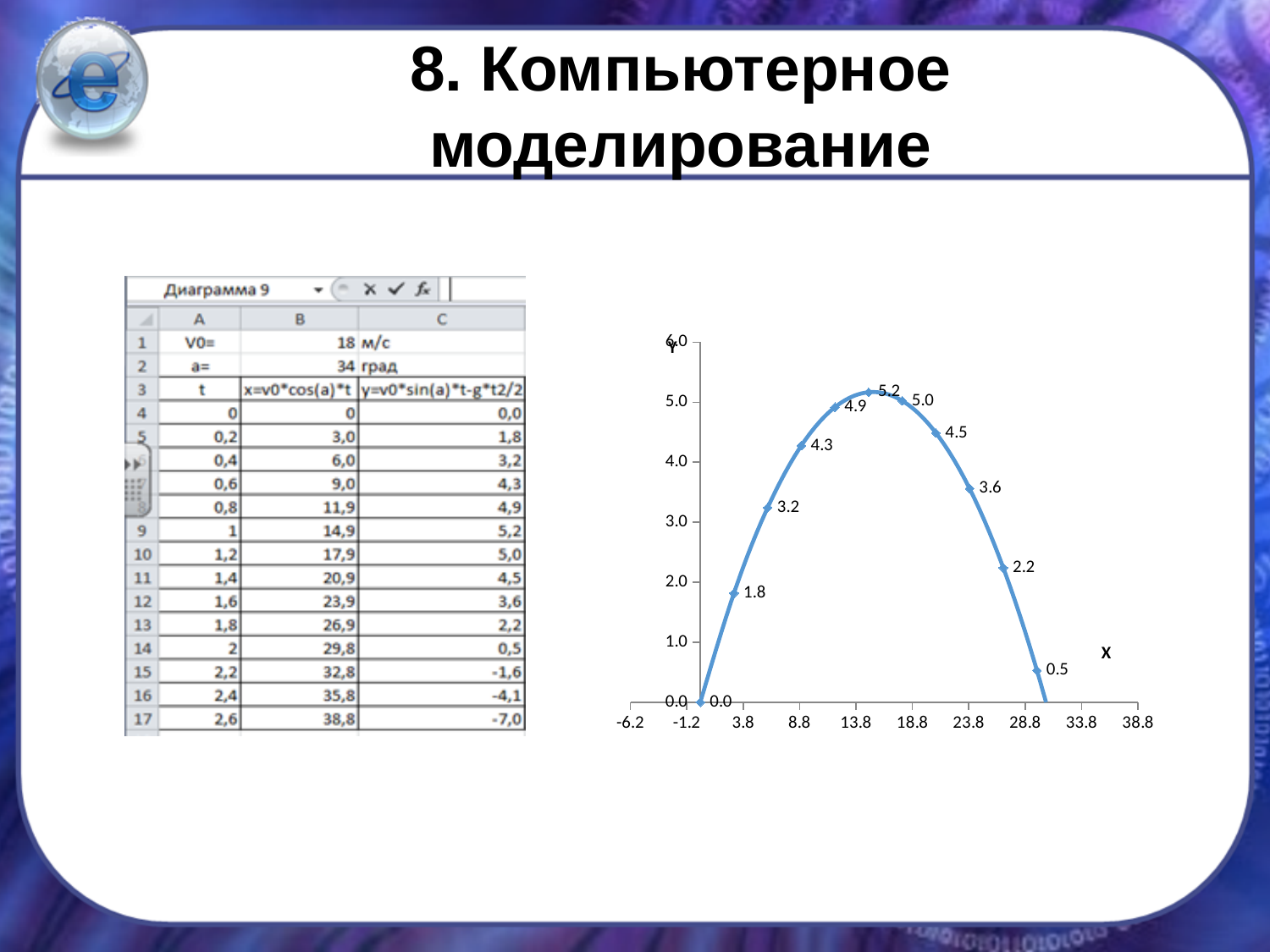
How many labelled data points are on the curve? 11 What is the data label of the last labelled point on the right side of the curve? 0.5 What is the difference between the data labels 5.2 and 1.8? 3.4 What is the lowest data label on the curve? 0.0 What is the data label of the first point on the left, at the origin? 0.0 What are the titles of the horizontal and vertical axes? X and Y How do the values change along the x axis? They rise to a peak of 5.2 and then fall What is the highest data label on the curve? 5.2 What is the difference between the highest data label (5.2) and the label 0.5 at the right end of the curve? 4.7 Which is larger: the data label 4.9 on the left of the peak or the data label 5.0 on the right of the peak? 5.0 What kind of chart is shown on the slide? line chart What is the highest tick value shown on the vertical axis? 6.0